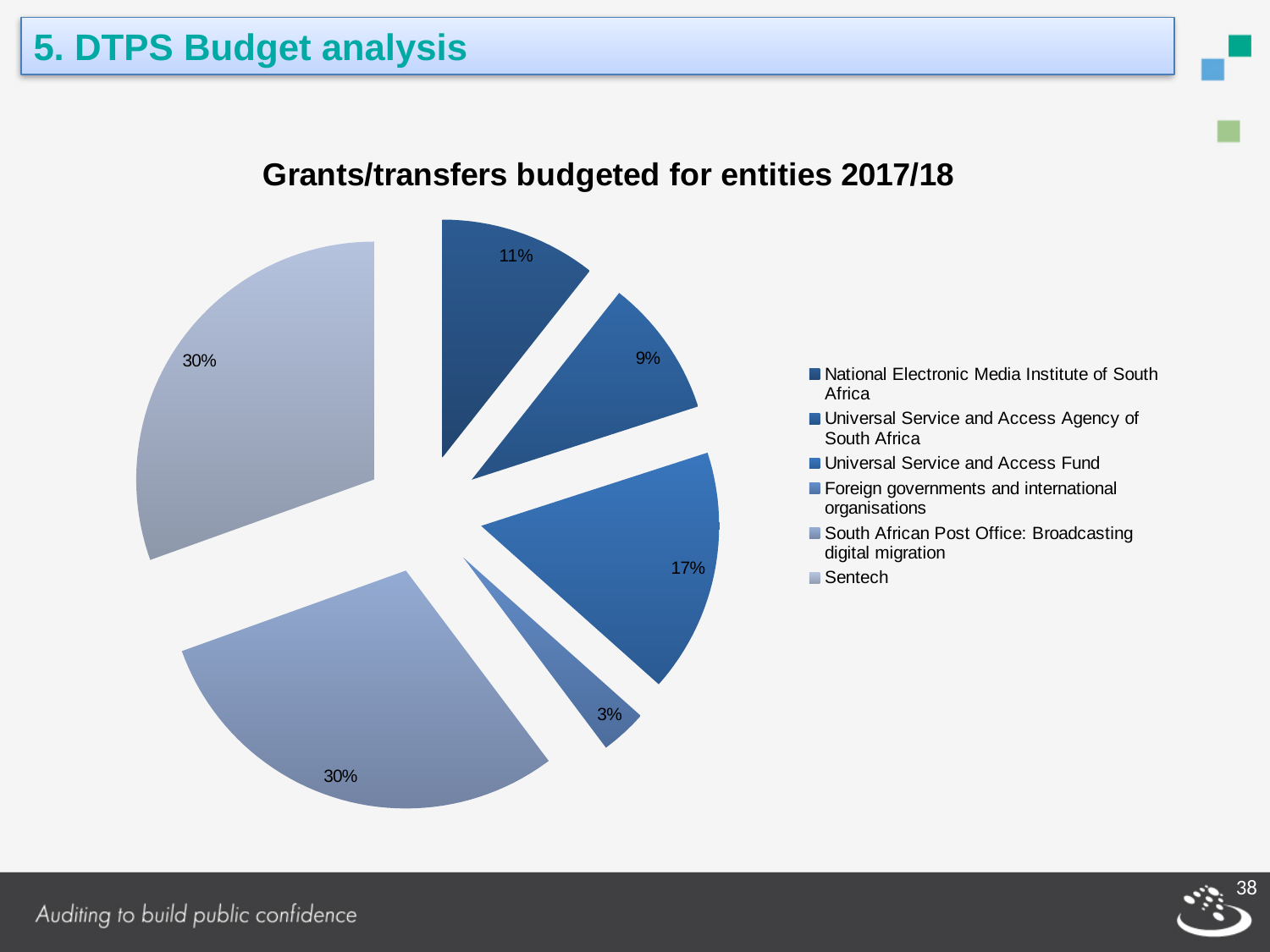
What is the combined share of South African Post Office: Broadcasting digital migration and Sentech? 60% What share of the pie does the Universal Service and Access Agency of South Africa have? 9% What share of the pie does the Universal Service and Access Fund have? 17% How many slices does the pie chart have? 6 What share of the pie does Sentech have? 30% What is the difference in percentage points between the Universal Service and Access Fund and the National Electronic Media Institute of South Africa? 6 What kind of chart is shown on the slide? Pie chart What share of the pie does the National Electronic Media Institute of South Africa have? 11% Which has the larger share: the Universal Service and Access Fund or the Universal Service and Access Agency of South Africa? Universal Service and Access Fund What share of the pie does Foreign governments and international organisations have? 3% What is the title of the chart? Grants/transfers budgeted for entities 2017/18 Which entity has the smallest share of the pie? Foreign governments and international organisations